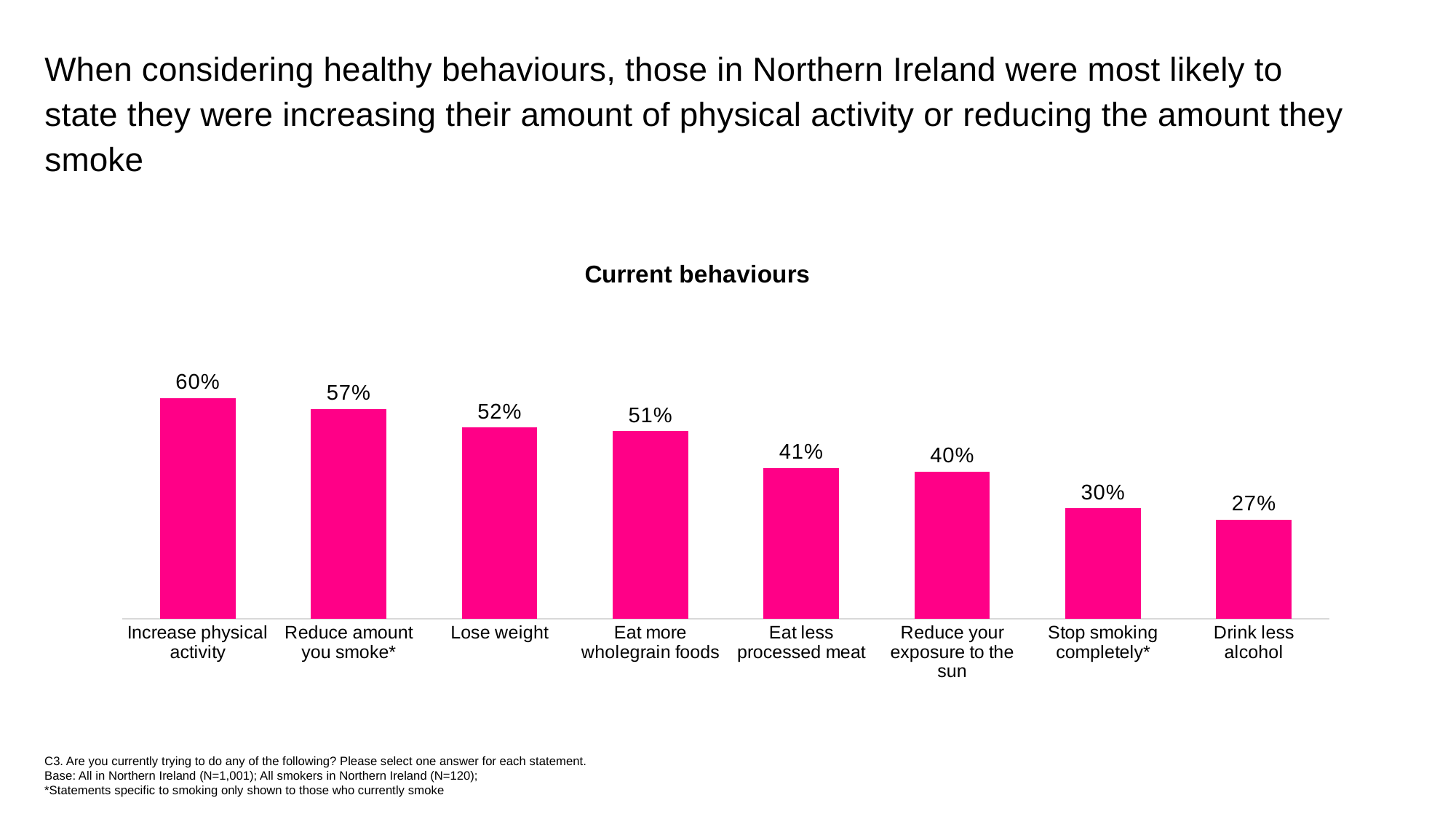
What colour are the bars in the chart? Pink How many categories are shown in the chart? 8 What kind of chart is shown on the slide? Bar chart What is the difference between the values for Lose weight and Stop smoking completely*? 22% Which is larger, the value for Reduce amount you smoke* or the value for Eat more wholegrain foods? Reduce amount you smoke* What is the value for Increase physical activity? 60% Which category has the highest value? Increase physical activity What is the title of the chart? Current behaviours What is the value for Drink less alcohol? 27% Which category has the lowest value? Drink less alcohol What is the value for Eat less processed meat? 41% Do the values rise or fall from left to right across the categories? Fall